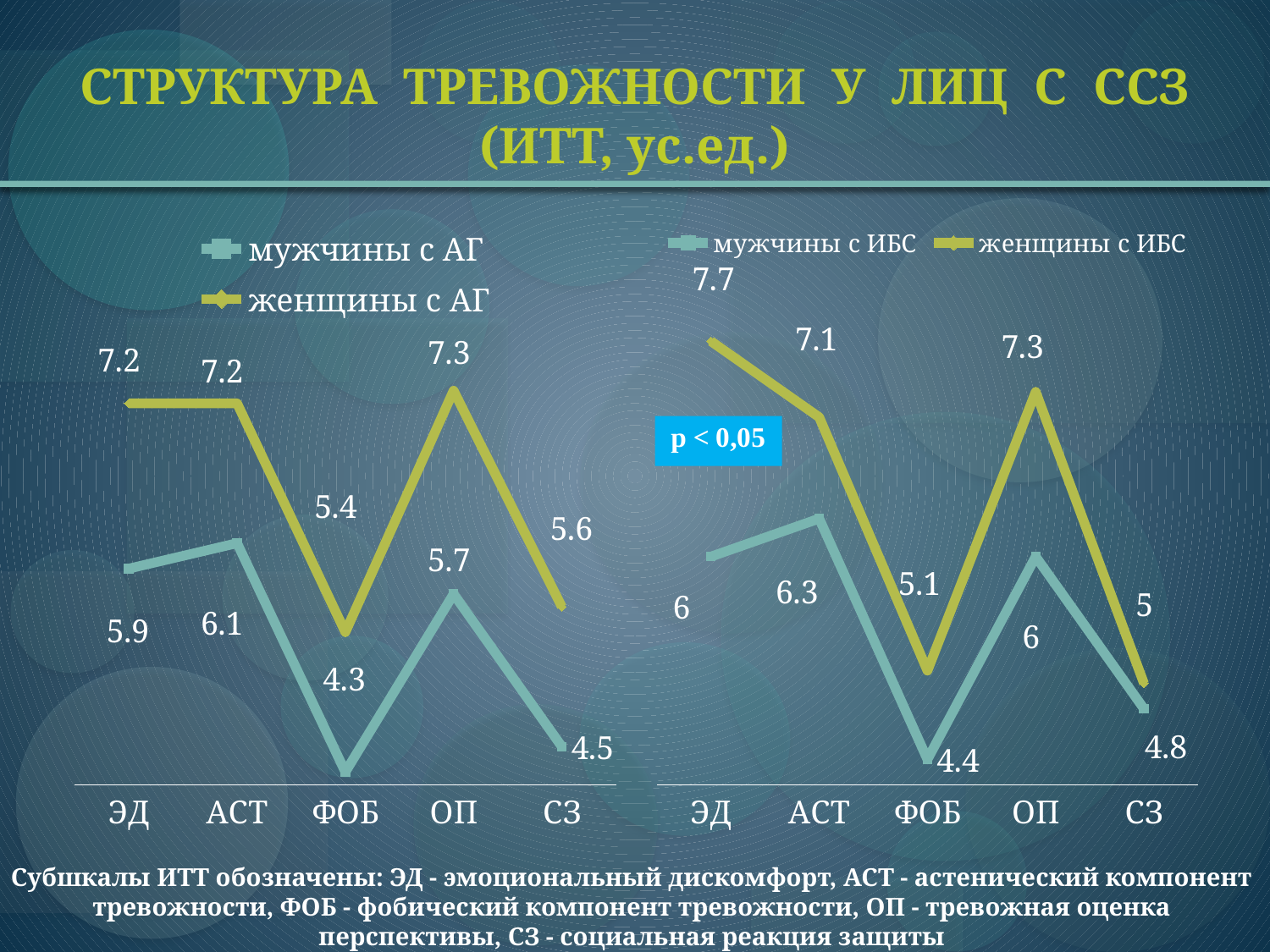
In the left chart (мужчины с АГ / женщины с АГ), what is the value for мужчины с АГ at ОП? 5.7 How many series does the legend of the right chart (мужчины с ИБС / женщины с ИБС) list? 2 In the right chart (мужчины с ИБС / женщины с ИБС), what is the value for женщины с ИБС at ЭД? 7.7 In the right chart (мужчины с ИБС / женщины с ИБС), which is larger at АСТ: мужчины с ИБС or женщины с ИБС? женщины с ИБС In the right chart (мужчины с ИБС / женщины с ИБС), what is the difference between женщины с ИБС and мужчины с ИБС at ФОБ? 0.7 What kind of chart is the left chart (мужчины с АГ / женщины с АГ)? Line chart In the right chart (мужчины с ИБС / женщины с ИБС), what is the value for мужчины с ИБС at СЗ? 4.8 How many categories are shown on the x axis of the left chart (мужчины с АГ / женщины с АГ)? 5 In the left chart (мужчины с АГ / женщины с АГ), at which category is the value for мужчины с АГ lowest? ФОБ In the left chart (мужчины с АГ / женщины с АГ), what is the value for женщины с АГ at ФОБ? 5.4 In the left chart (мужчины с АГ / женщины с АГ), what is the difference between женщины с АГ and мужчины с АГ at ОП? 1.6 In the right chart (мужчины с ИБС / женщины с ИБС), at which category is the value for женщины с ИБС highest? ЭД